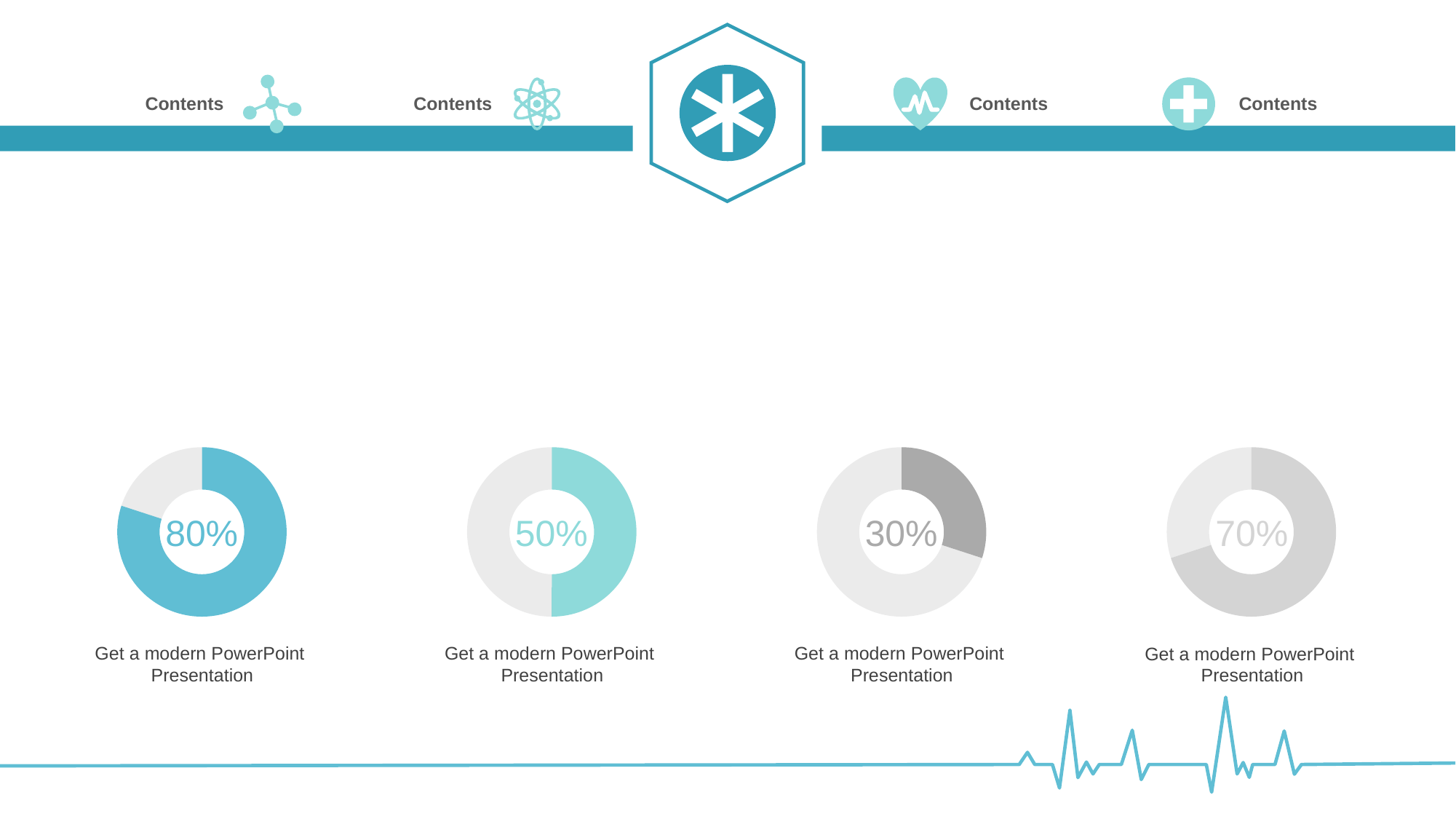
Which donut chart on the slide shows the highest percentage? The leftmost chart (80%) What is the difference between the percentages in the rightmost and second donut charts? 20% What percentage is shown in the centre of the rightmost donut chart? 70% What percentage is shown in the centre of the leftmost donut chart? 80% What colour is the filled portion of the leftmost donut chart? Blue What percentage is shown in the centre of the third donut chart from the left? 30% What percentage is shown in the centre of the second donut chart from the left? 50% Which shows a larger percentage, the second donut chart or the rightmost donut chart? The rightmost donut chart (70%) What is the difference between the percentage in the leftmost donut chart and the percentage in the third donut chart? 50% What kind of chart is used to display the percentages on the slide? Donut chart How many donut charts are on the slide? 4 Which donut chart on the slide shows the lowest percentage? The third chart from the left (30%)